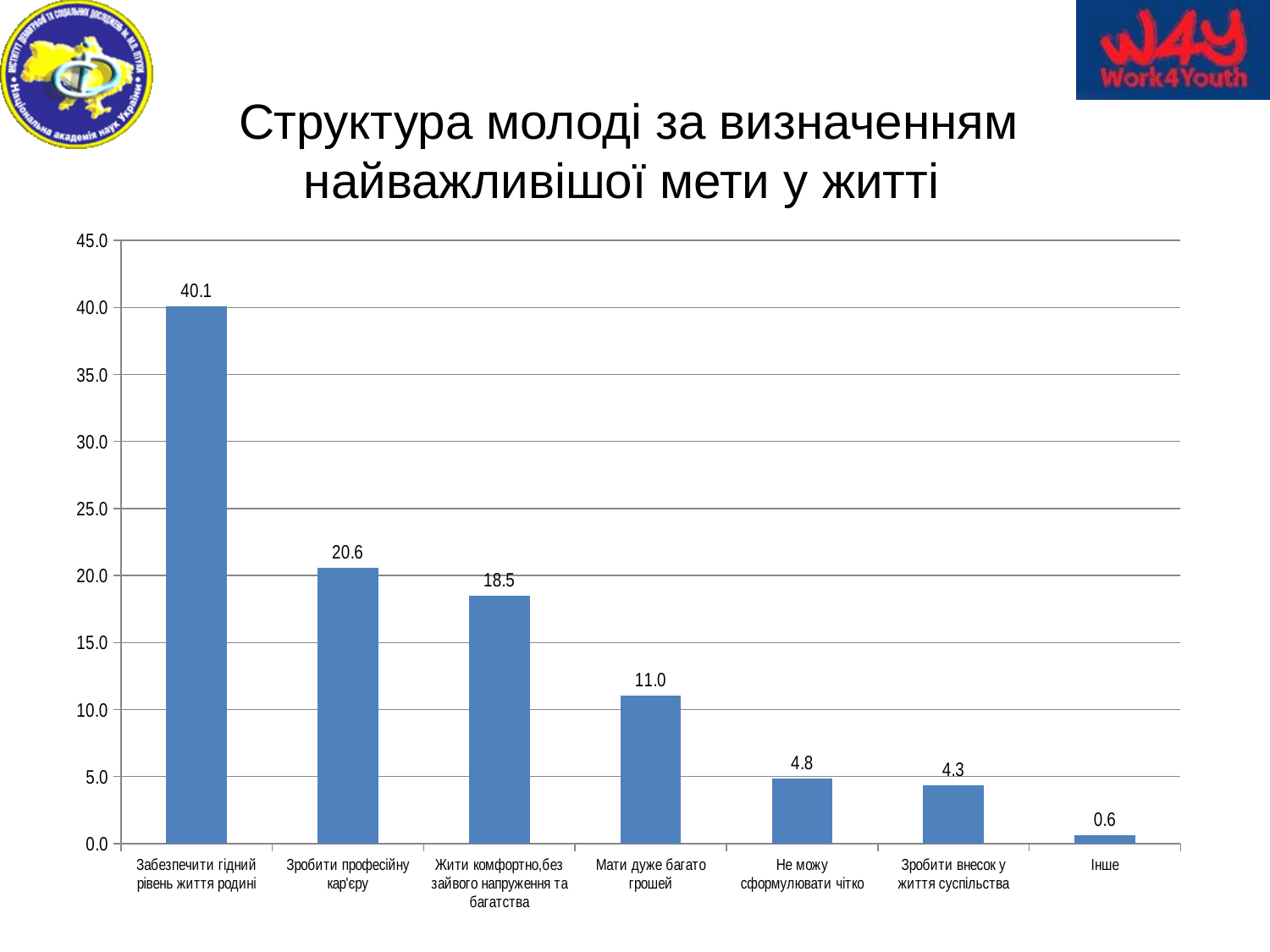
What is the difference between the values for "Зробити професійну кар'єру" and "Жити комфортно,без зайвого напруження та багатства"? 2.1 What is the value for "Забезпечити гідний рівень життя родині"? 40.1 Which category has the highest value? Забезпечити гідний рівень життя родині Is the value for "Зробити професійну кар'єру" greater or less than 20.0? greater What is the title of the chart on the slide? Структура молоді за визначенням найважливішої мети у житті Which category has the lowest value? Інше Do the values rise or fall from left to right along the x axis? fall How many categories are shown on the chart? 7 Which is larger: the value for "Не можу сформулювати чітко" or for "Зробити внесок у життя суспільства"? Не можу сформулювати чітко What is the value for "Мати дуже багато грошей"? 11.0 What is the value for "Інше"? 0.6 What kind of chart is shown on the slide? bar chart